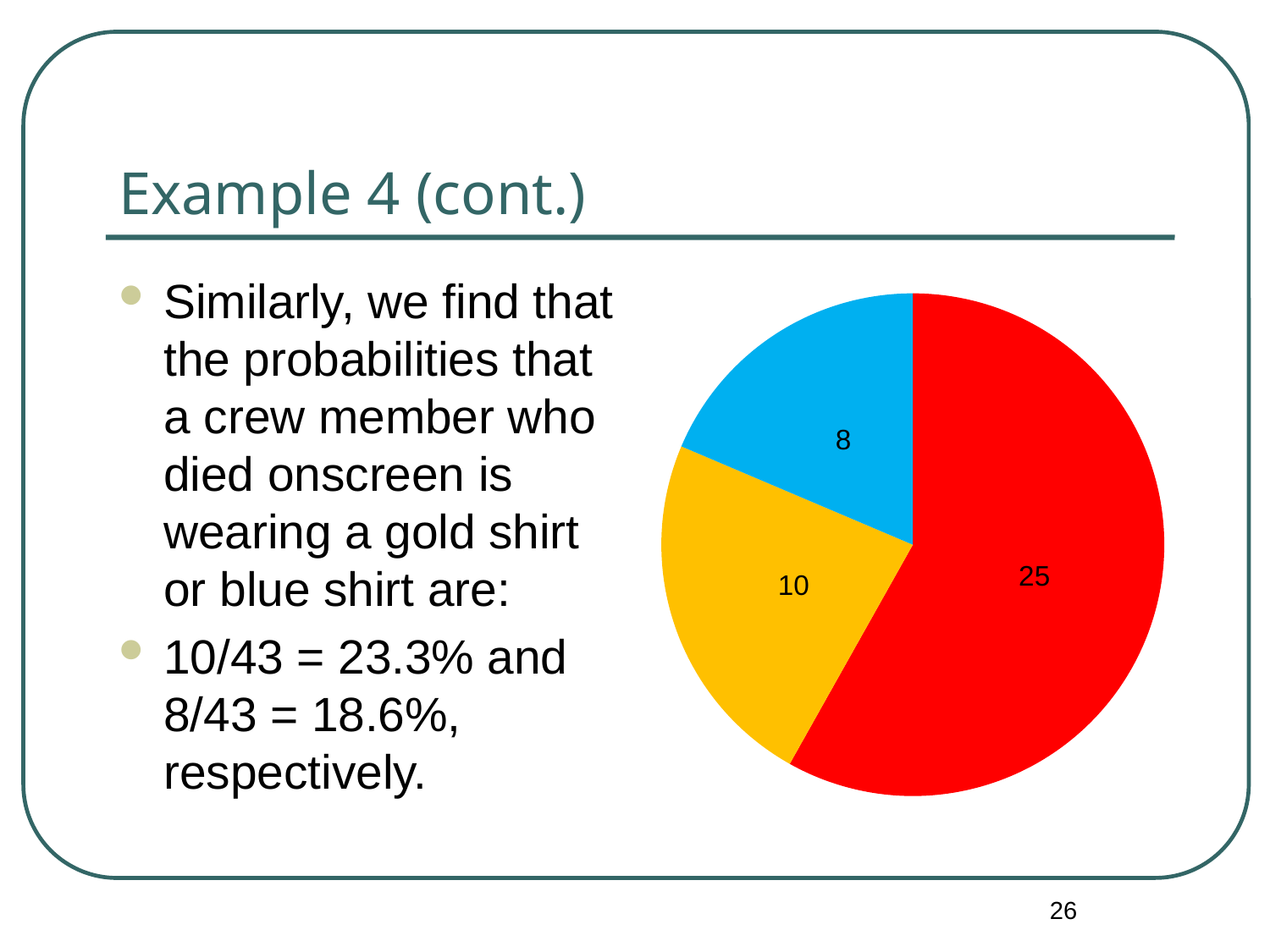
What is the difference between the red slice value and the gold slice value? 15 What value is shown on the red slice of the pie chart? 25 What share of the pie does the gold slice (10) represent? 23.3% What is the difference between the gold slice value and the blue slice value? 2 What value is shown on the gold slice of the pie chart? 10 Which is larger, the gold slice or the blue slice? the gold slice What value is shown on the blue slice of the pie chart? 8 Which slice of the pie chart has the smallest value? the blue slice (8) What is the total of all the slice values in the pie chart? 43 How many slices does the pie chart have? 3 What type of chart is shown on the slide? pie chart Which slice of the pie chart has the largest value? the red slice (25)